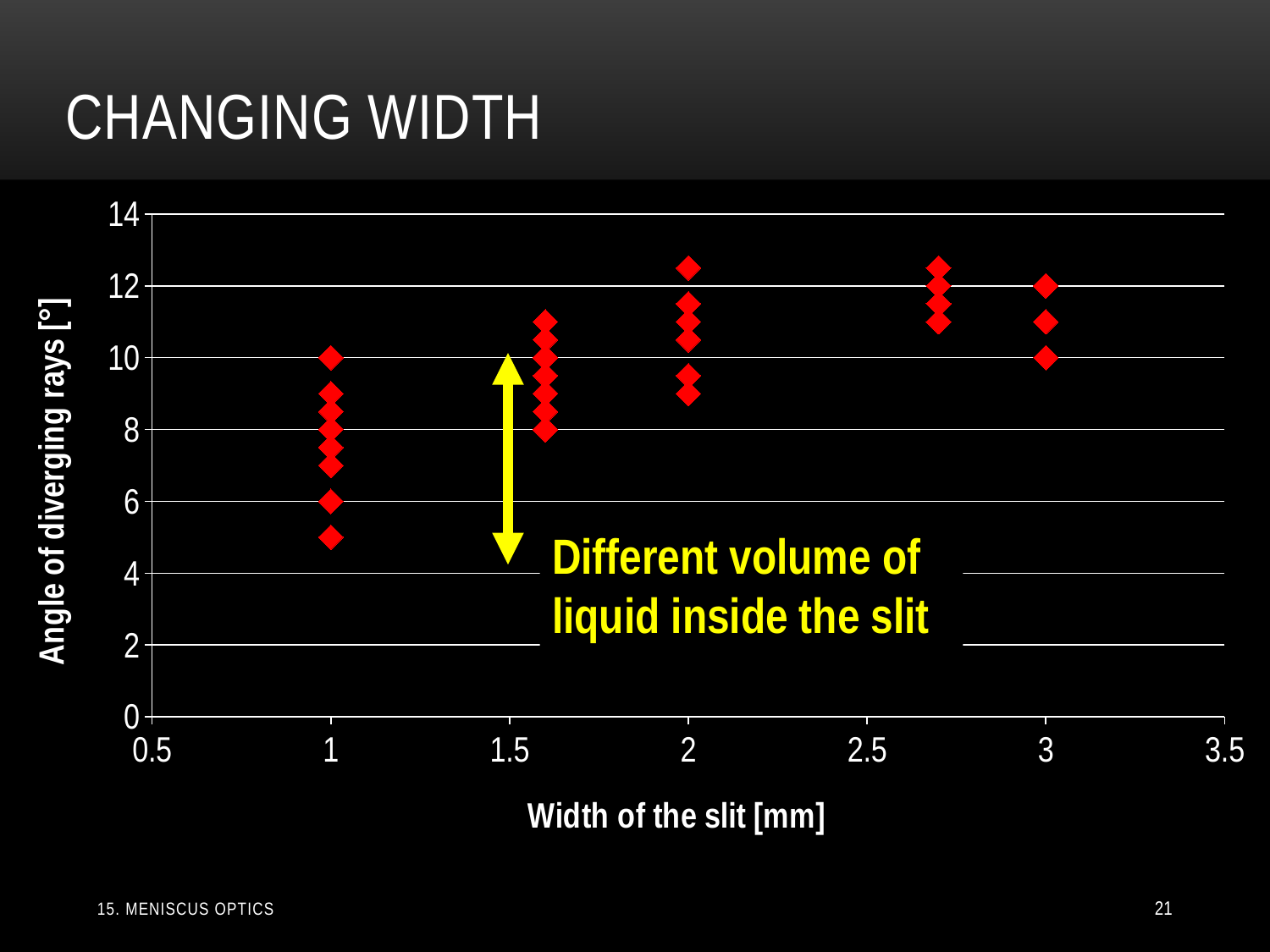
Do the angle values generally rise or fall as the slit width increases? rise What is the title of the chart's x axis? Width of the slit [mm] At which slit width is the single lowest angle value plotted? 1 What is the title of the chart's y axis? Angle of diverging rays [°] What kind of chart is shown on the slide? scatter chart Is the lowest angle value at a slit width of 1 mm greater or less than 6? less Is the lowest angle value at a slit width of 2 mm greater or less than 8? greater What is the highest angle value plotted at a slit width of 3 mm? 12 What is the highest angle value plotted at a slit width of 1 mm? 10 What is the lowest angle value plotted at a slit width of 3 mm? 10 At how many different slit widths are data points plotted? 5